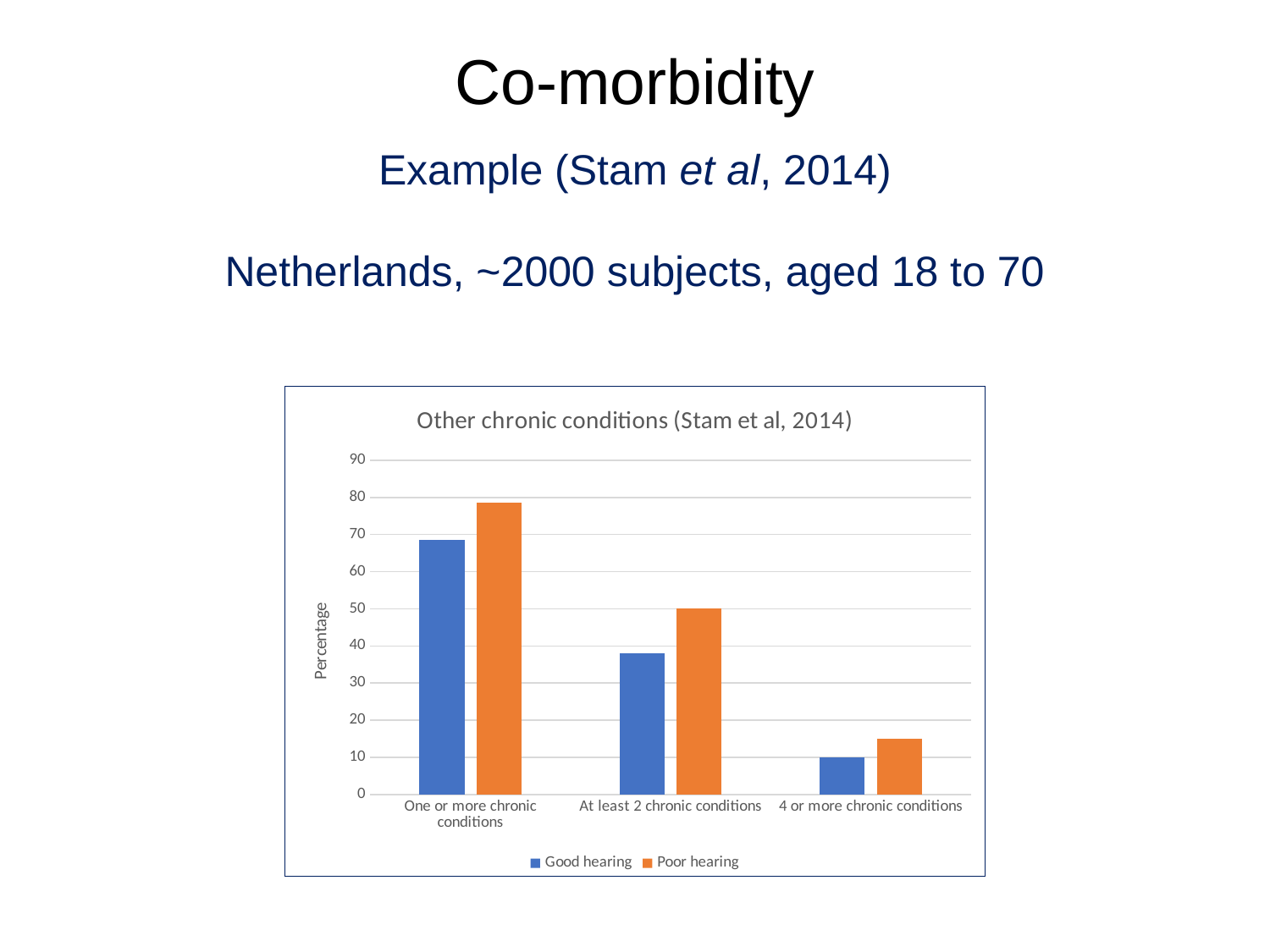
In the 'At least 2 chronic conditions' category, which series has the larger value, Good hearing or Poor hearing? Poor hearing How many categories are shown on the x axis of the chart? 3 What kind of chart is shown on the slide? bar chart Is the value for Poor hearing in the '4 or more chronic conditions' category greater or less than 20? less What is the title of the chart? Other chronic conditions (Stam et al, 2014) How many series does the chart legend list? 2 What is the label on the vertical axis of the chart? Percentage Which category has the lowest value for Good hearing? 4 or more chronic conditions Is the value for Good hearing in the 'At least 2 chronic conditions' category greater or less than 40? less Which category has the highest value for Poor hearing? One or more chronic conditions Is the value for Poor hearing in the 'One or more chronic conditions' category greater or less than 70? greater Do the Good hearing values rise or fall from left to right across the categories? fall